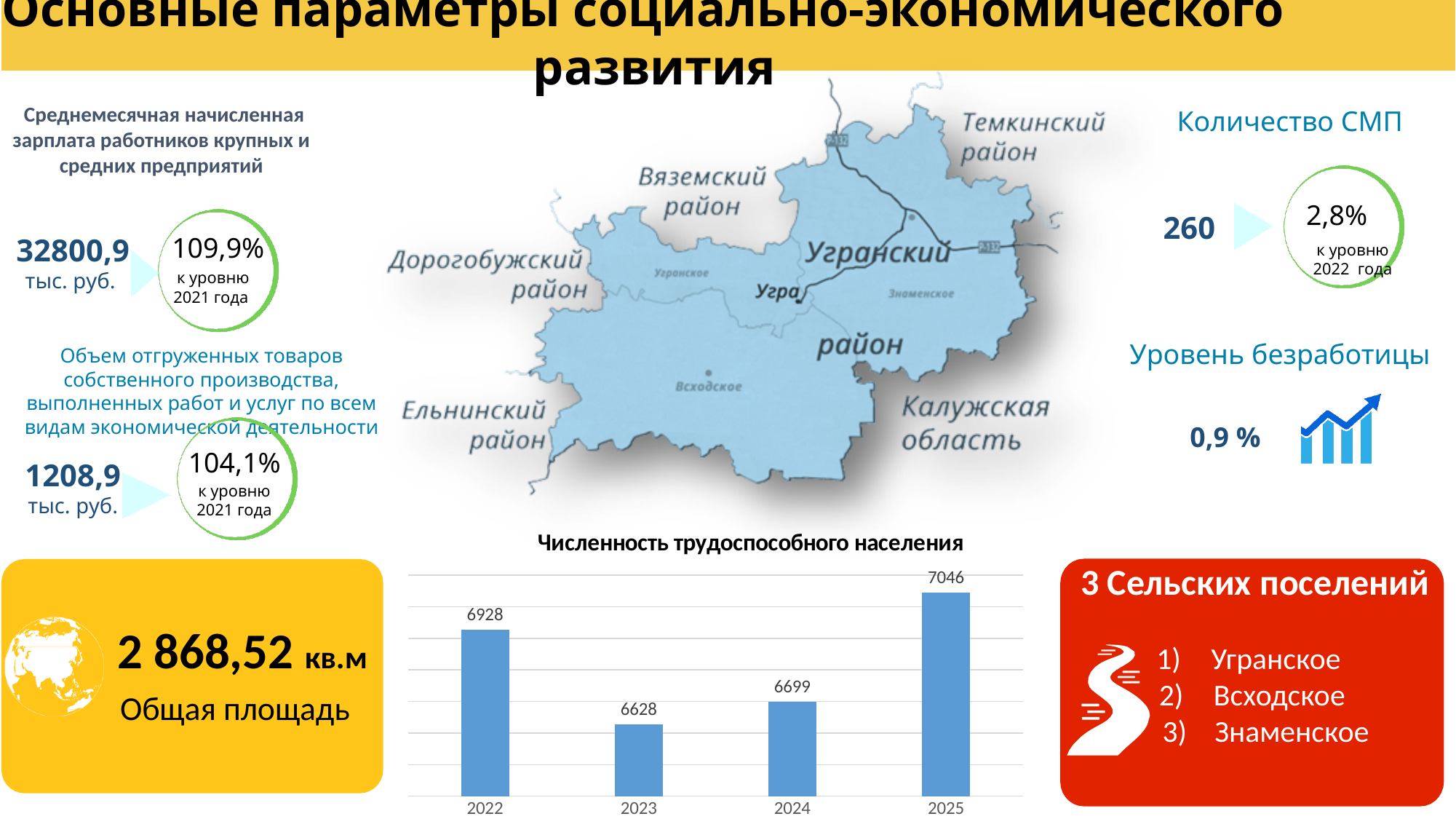
What kind of chart is 'Численность трудоспособного населения'? bar chart How many years are shown in the chart 'Численность трудоспособного населения'? 4 What is the difference between the 2024 and 2023 values in the chart 'Численность трудоспособного населения'? 71 What is the value for 2023 in the chart 'Численность трудоспособного населения'? 6628 What is the value for 2025 in the chart 'Численность трудоспособного населения'? 7046 What is the title of the bar chart on the slide? Численность трудоспособного населения Which year has the lowest value in the chart 'Численность трудоспособного населения'? 2023 What is the difference between the 2025 and 2022 values in the chart 'Численность трудоспособного населения'? 118 In the chart 'Численность трудоспособного населения', which is larger: the value for 2022 or the value for 2024? 2022 What is the value for 2022 in the chart 'Численность трудоспособного населения'? 6928 Which year has the highest value in the chart 'Численность трудоспособного населения'? 2025 What is the value for 2024 in the chart 'Численность трудоспособного населения'? 6699